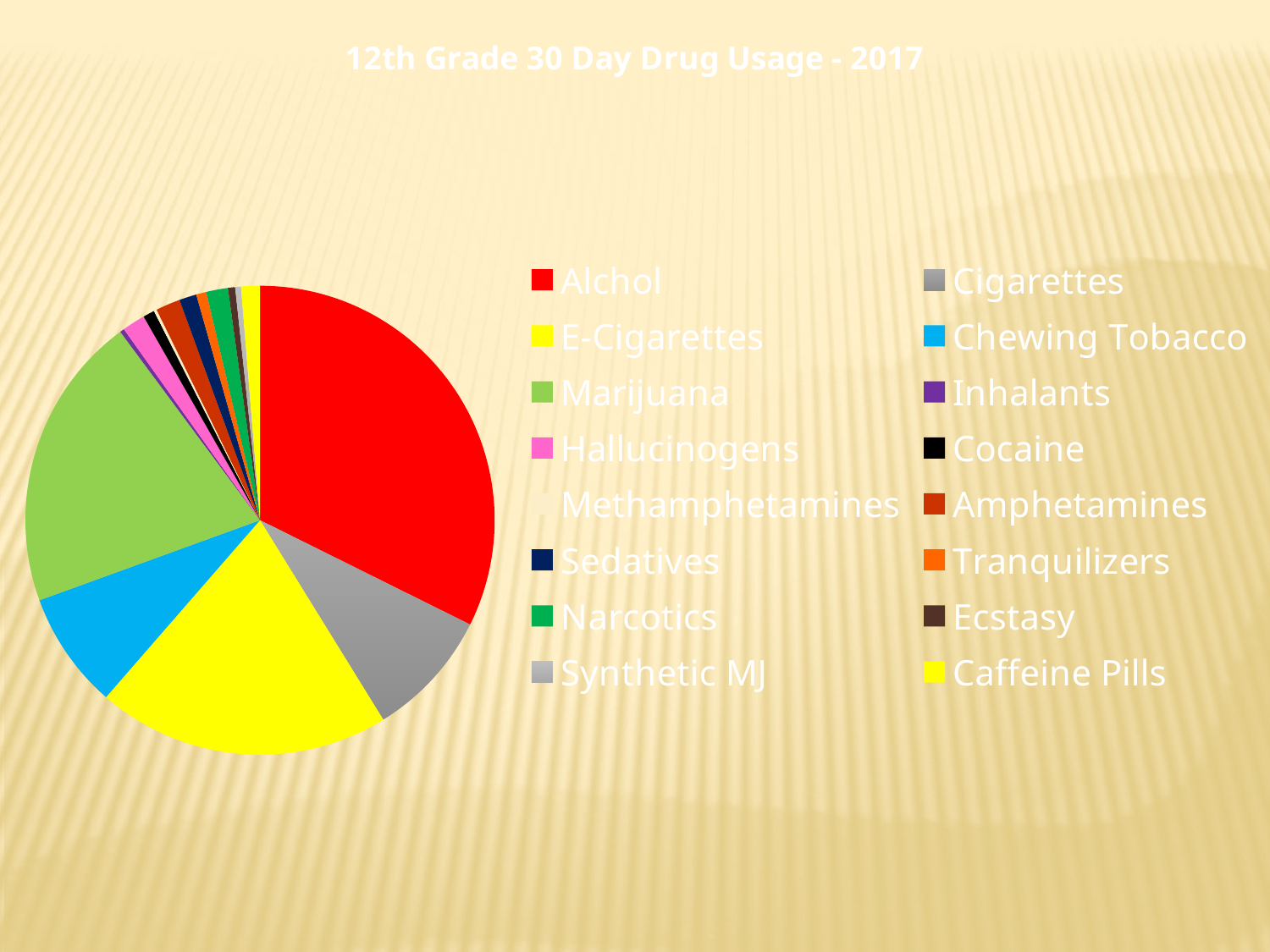
How many categories does the legend of the pie chart list? 16 What is the title of the chart? 12th Grade 30 Day Drug Usage - 2017 What colour is the Alchol slice in the pie chart? red Which category has the largest slice of the pie? Alchol What kind of chart is shown on the slide? pie chart Which slice is larger, Alchol or Marijuana? Alchol Which slice is larger, E-Cigarettes or Cigarettes? E-Cigarettes Which slice is larger, E-Cigarettes or Hallucinogens? E-Cigarettes